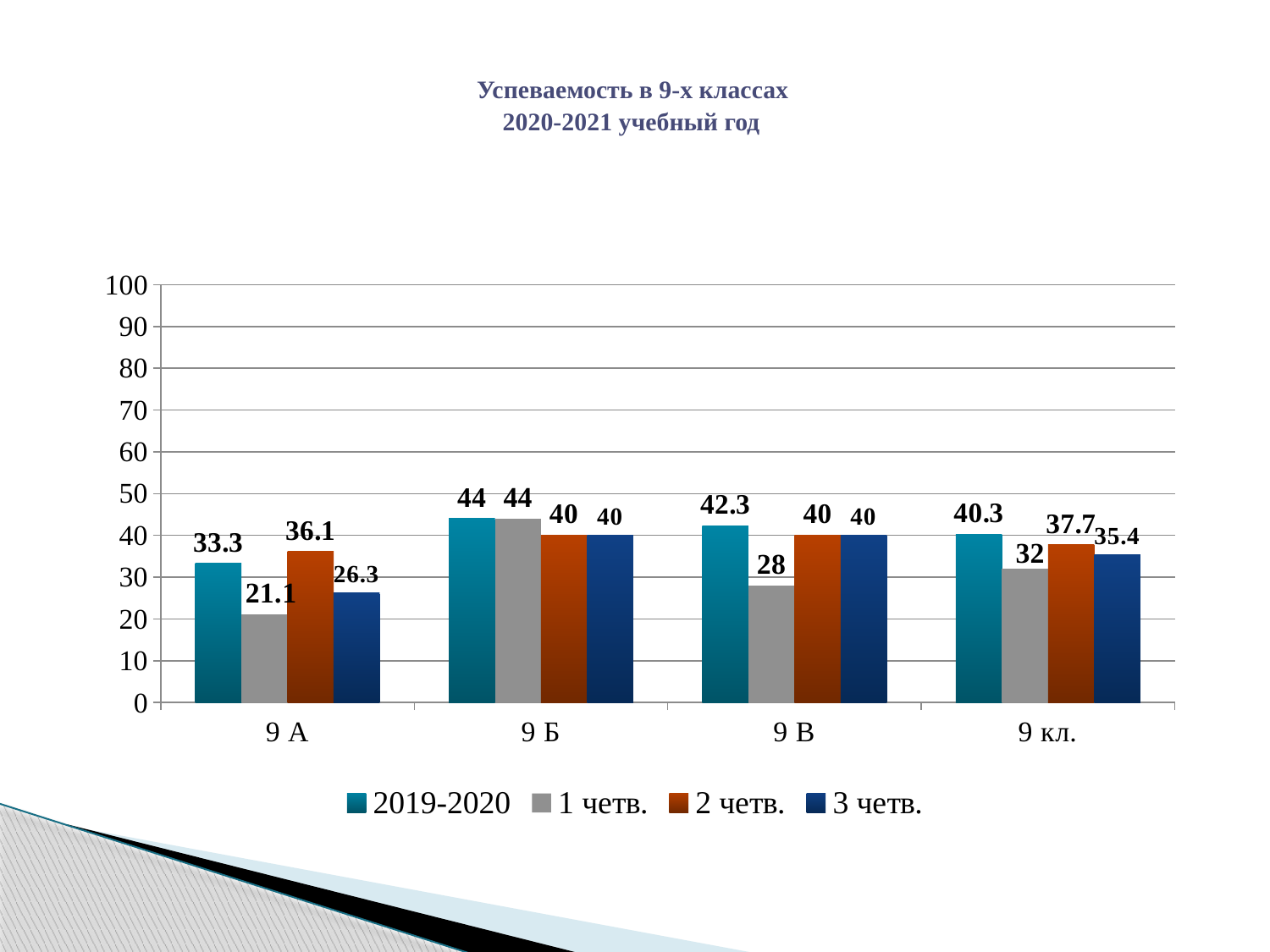
Which category has the highest value in the 2019-2020 series? 9 Б What is the value for 9 А in the 2019-2020 series? 33.3 Which is larger for 9 кл.: the 2019-2020 value or the 2 четв. value? 2019-2020 Is the value for 9 Б in the 2019-2020 series greater or less than 40? greater Which category has the lowest value in the 1 четв. series? 9 А What is the difference between the 2 четв. and 1 четв. values for 9 А? 15 How many categories are shown on the x axis? 4 What is the title of the chart? Успеваемость в 9-х классах 2020-2021 учебный год What is the value for 9 кл. in the 3 четв. series? 35.4 What is the value for 9 В in the 1 четв. series? 28 How many series does the legend list? 4 What kind of chart is shown on the slide? bar chart